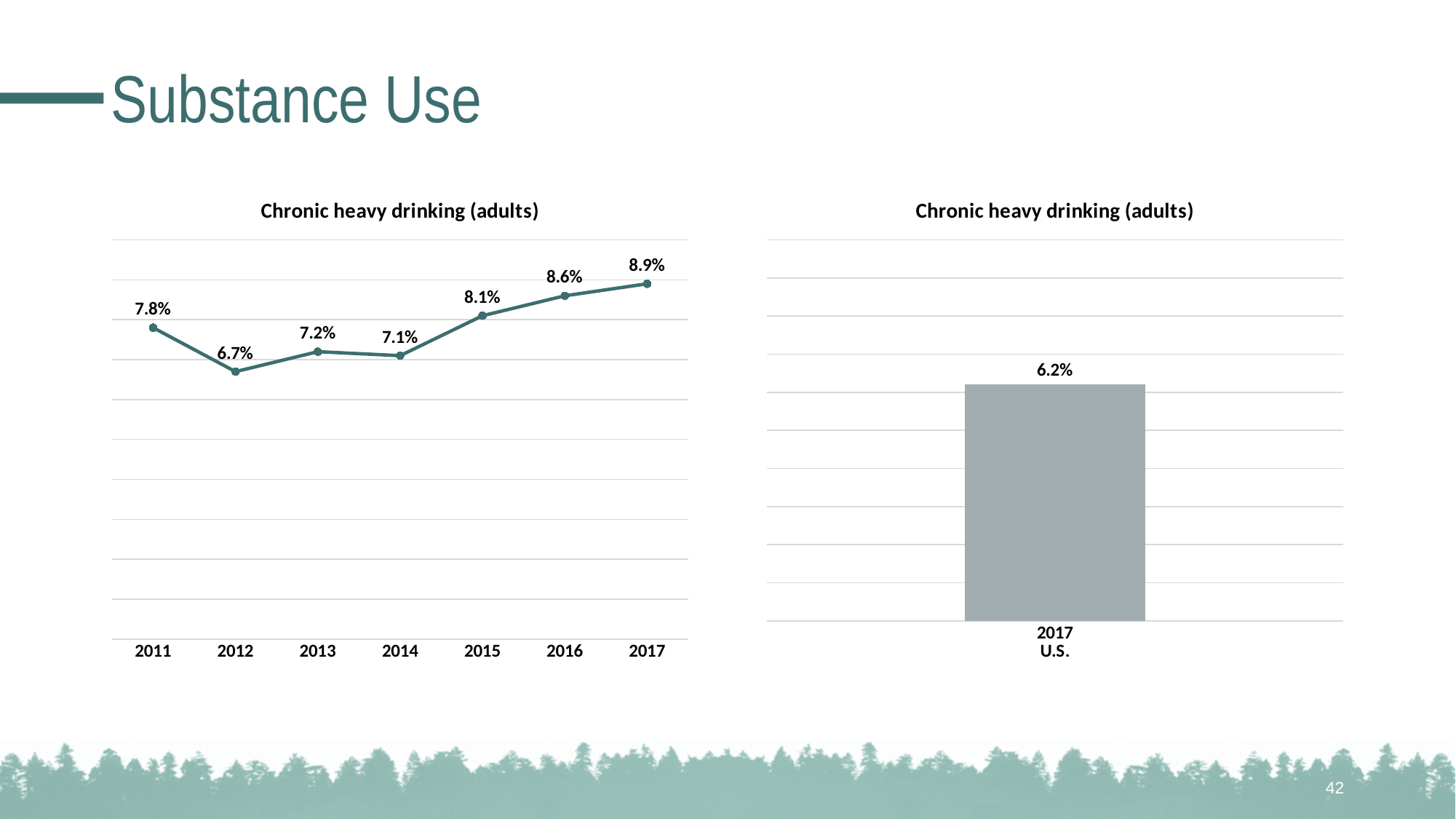
What kind of chart is the right chart? Bar chart In the left chart (line chart), what is the value for 2011? 7.8% What is the title of the right chart? Chronic heavy drinking (adults) What kind of chart is the left chart? Line chart In the right chart (bar chart), what is the value for 2017 U.S.? 6.2% In the left chart (line chart), which is larger, the value for 2013 or the value for 2014? 2013 How many years are plotted in the left chart (line chart)? 7 In the left chart (line chart), which year has the highest value? 2017 In the left chart (line chart), what is the difference between the 2017 value and the 2011 value? 1.1% In the left chart (line chart), which year has the lowest value? 2012 In the left chart (line chart), what is the value for 2014? 7.1% In the left chart (line chart), do the values rise or fall from 2014 to 2017? Rise